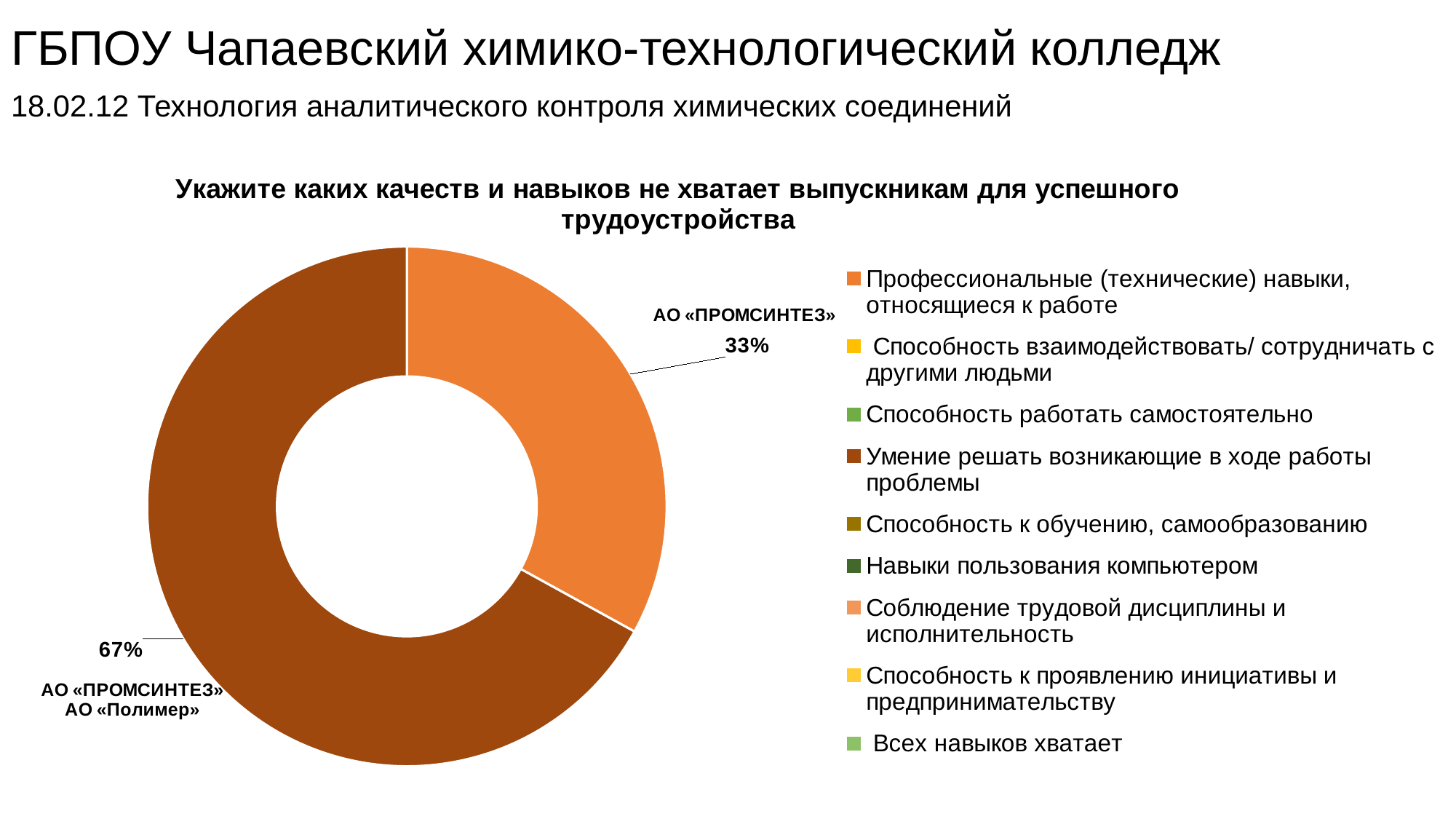
How many entries does the legend list? 9 What is the difference in percentage points between the 67% slice and the 33% slice? 34 What share of the chart does the slice for "Профессиональные (технические) навыки, относящиеся к работе" take? 33% Which category has the smallest visible slice in the chart? Профессиональные (технические) навыки, относящиеся к работе What is the title of the chart? Укажите каких качеств и навыков не хватает выпускникам для успешного трудоустройства What is the total of the two labelled slices in the chart? 100% Which slice is larger: "Профессиональные (технические) навыки, относящиеся к работе" or "Умение решать возникающие в ходе работы проблемы"? Умение решать возникающие в ходе работы проблемы What kind of chart is shown on the slide? Doughnut (pie) chart Which category has the largest slice in the chart? Умение решать возникающие в ходе работы проблемы Which organisation is labelled next to the 33% slice? АО «ПРОМСИНТЕЗ» How many slices with data labels are visible in the chart? 2 What share of the chart does the slice for "Умение решать возникающие в ходе работы проблемы" take? 67%